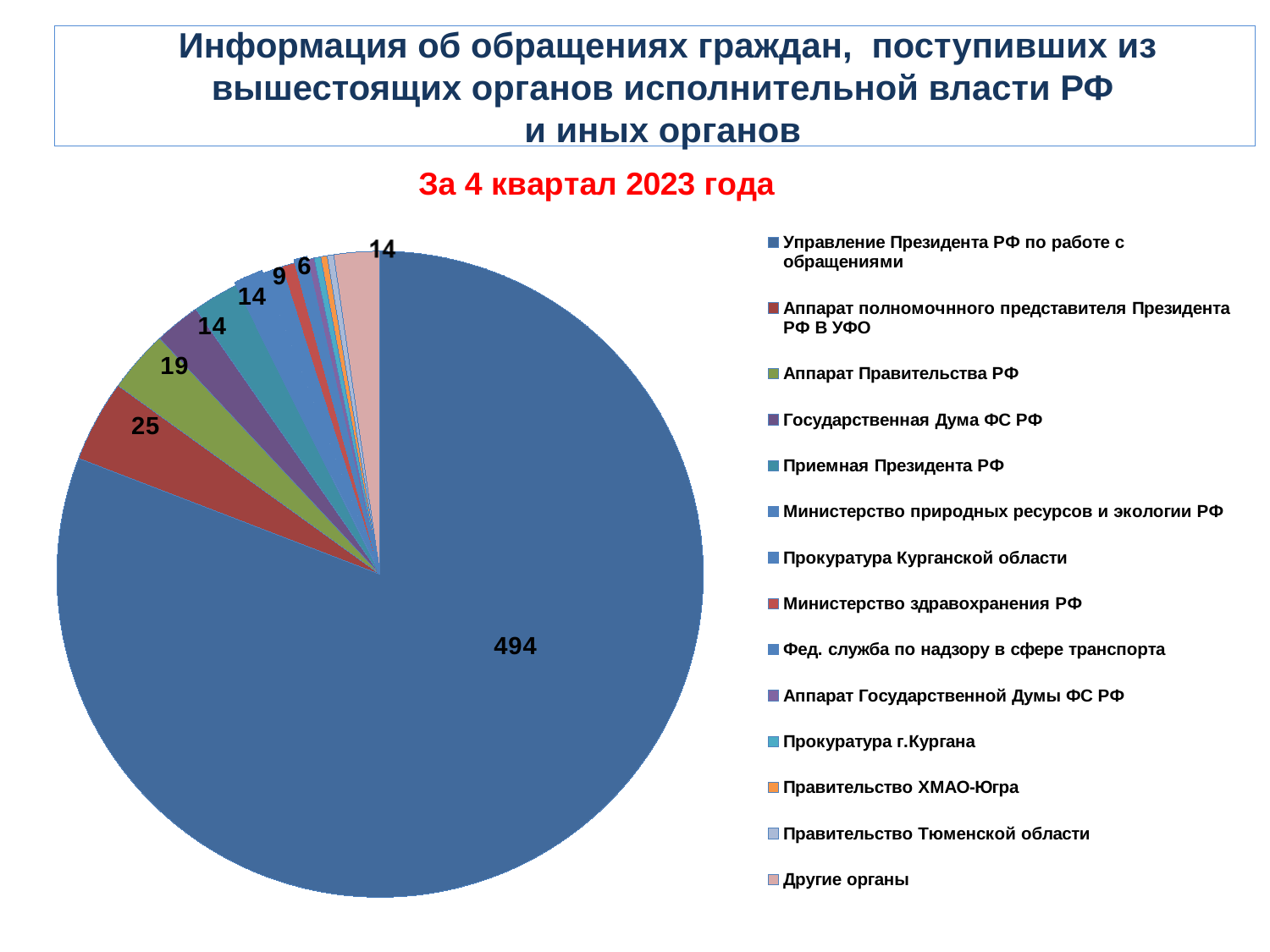
What is the difference between the values for Управление Президента РФ по работе с обращениями and Аппарат полномочнного представителя Президента РФ В УФО? 469 What is the value for Другие органы? 14 What period does the chart cover, according to the red subtitle? За 4 квартал 2023 года Which category has the largest slice of the pie? Управление Президента РФ по работе с обращениями What kind of chart is shown on the slide? pie chart How many categories does the legend of the pie chart list? 14 Which is larger: the value for Аппарат полномочнного представителя Президента РФ В УФО or for Аппарат Правительства РФ? Аппарат полномочнного представителя Президента РФ В УФО What is the value for Аппарат полномочнного представителя Президента РФ В УФО? 25 What is the value for Государственная Дума ФС РФ? 14 What is the difference between the values for Аппарат полномочнного представителя Президента РФ В УФО and Аппарат Правительства РФ? 6 What is the value for Аппарат Правительства РФ? 19 What is the value for Управление Президента РФ по работе с обращениями? 494